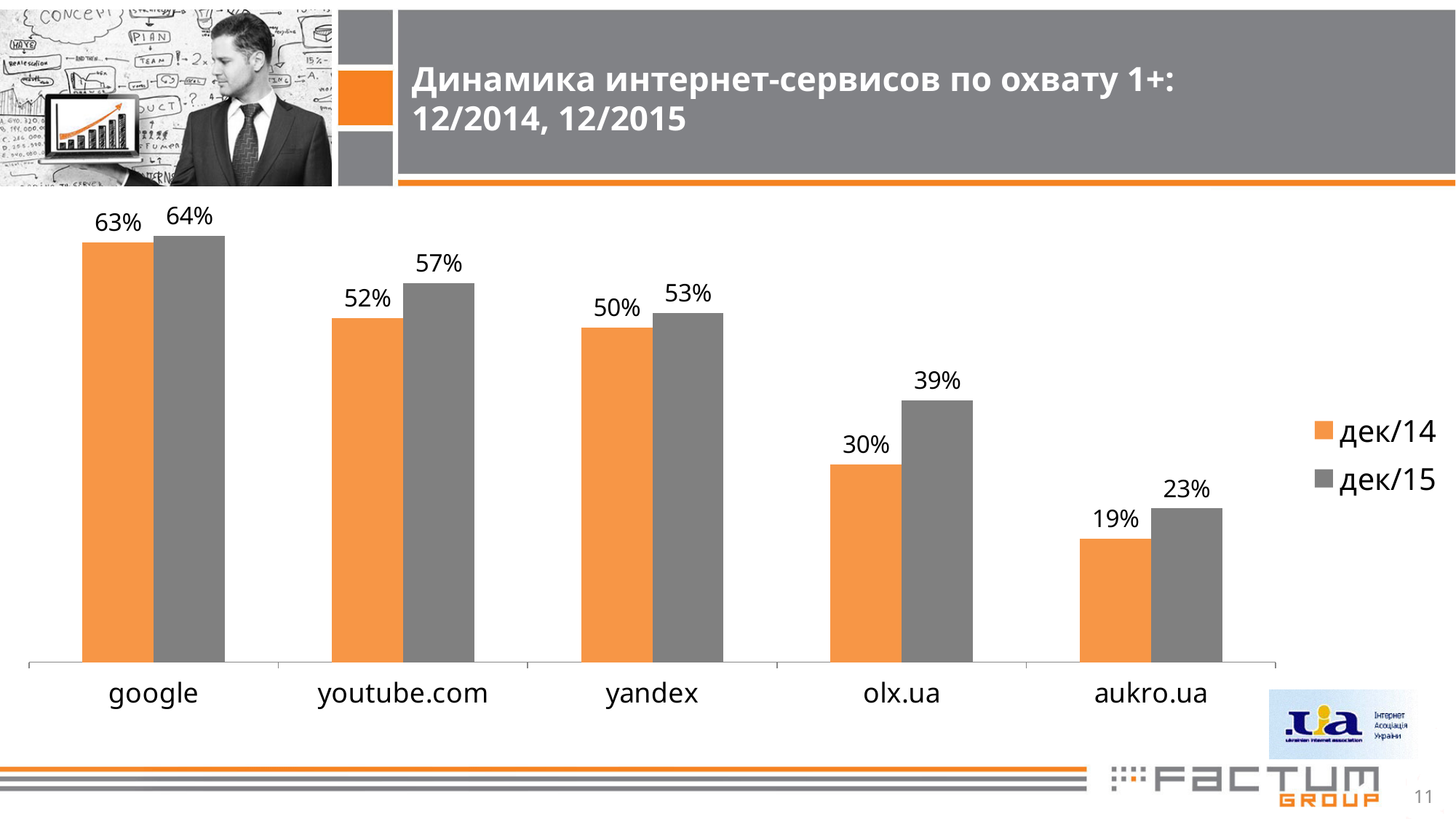
What is the value for google in the дек/15 series? 64% What is the difference between the дек/15 and дек/14 values for youtube.com? 5% What is the value for aukro.ua in the дек/15 series? 23% What is the difference between the дек/15 and дек/14 values for olx.ua? 9% Which category has the highest value in the дек/14 series? google How many series does the legend list? 2 What is the value for olx.ua in the дек/14 series? 30% What kind of chart is shown on the slide? bar chart Which colour represents the дек/14 series? orange Which category has the lowest value in the дек/15 series? aukro.ua How many categories are shown on the x axis? 5 Which is larger: the дек/14 value for yandex or the дек/14 value for youtube.com? youtube.com